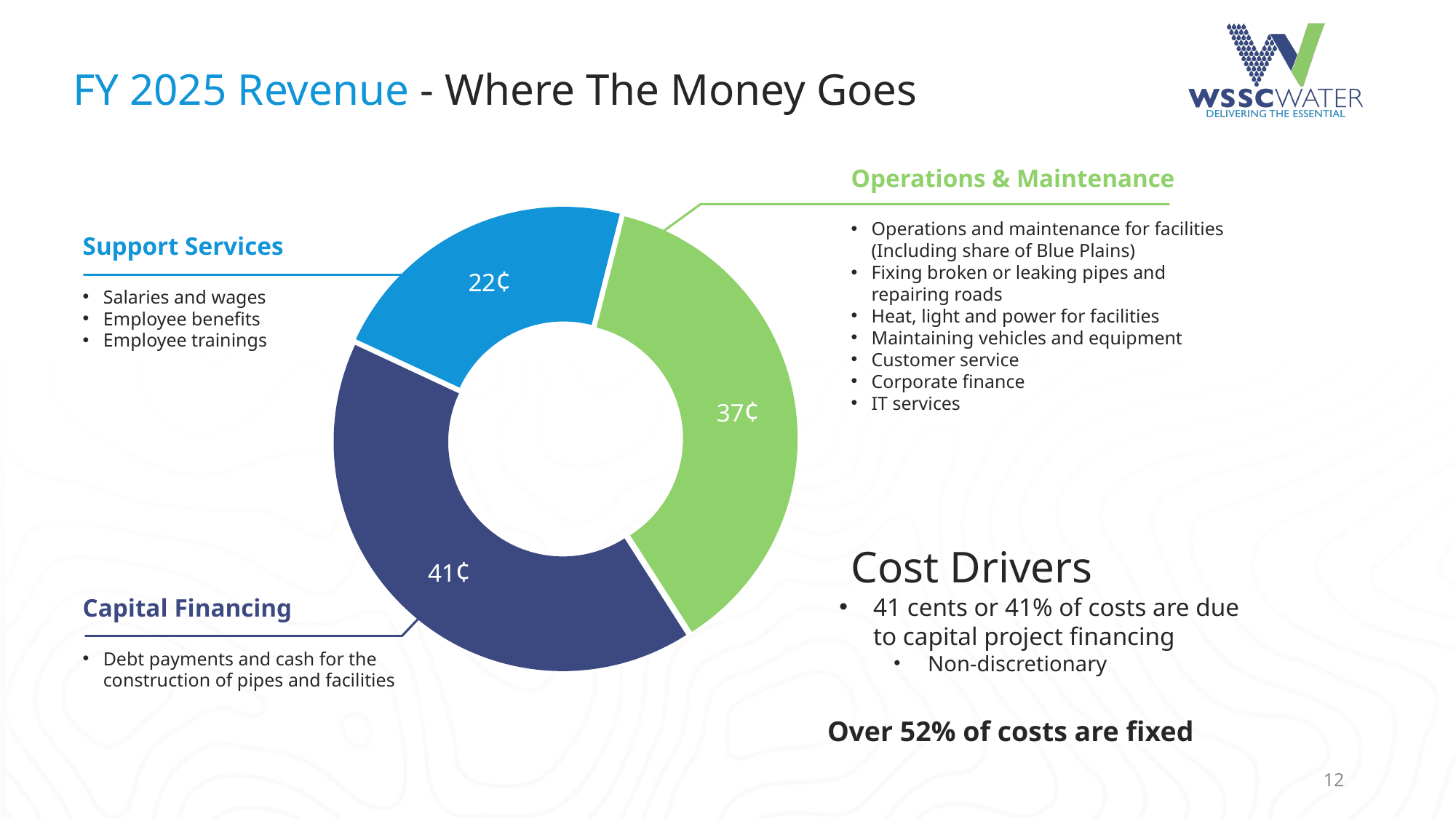
What kind of chart is shown on the slide? Donut (pie) chart What value is shown for Support Services on the donut chart? 22¢ Which category has the largest slice of the donut chart? Capital Financing How many categories are shown on the donut chart? 3 What is the difference between the Capital Financing and Support Services values? 19¢ What value is shown for Operations & Maintenance on the donut chart? 37¢ Which is larger, Operations & Maintenance or Support Services? Operations & Maintenance What is the total of the three values shown on the donut chart? 100¢ Which category has the smallest slice of the donut chart? Support Services What colour is the Operations & Maintenance slice of the donut chart? Green What value is shown for Capital Financing on the donut chart? 41¢ What is the difference between the Operations & Maintenance and Support Services values? 15¢